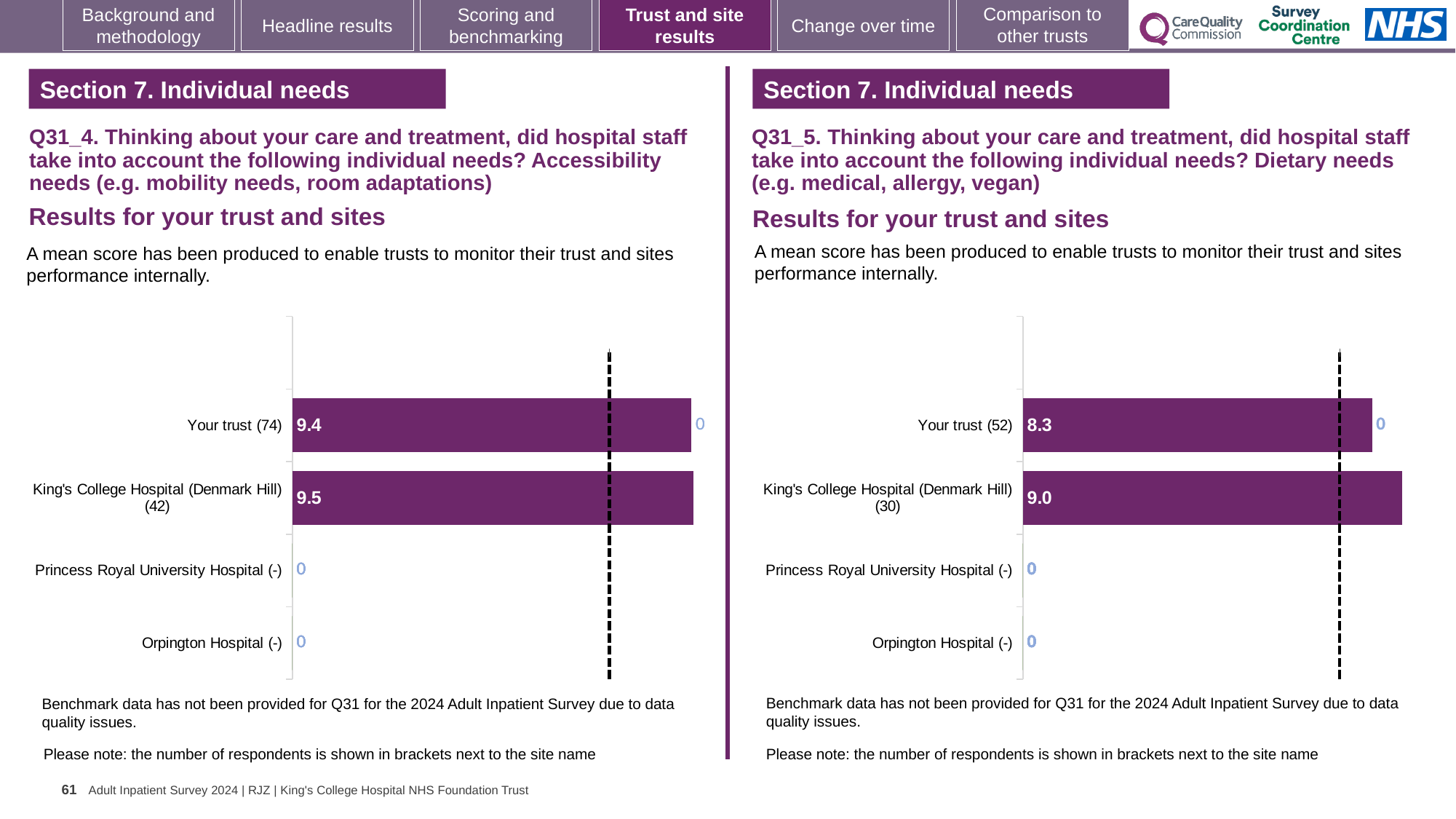
In the right chart (Q31_5), how many respondents are shown in brackets for King's College Hospital (Denmark Hill)? 30 In the right chart (Q31_5, dietary needs), which is larger: the score for Your trust or for King's College Hospital (Denmark Hill)? King's College Hospital (Denmark Hill) What type of chart is used in the right chart (Q31_5, dietary needs)? Bar chart In the left chart (Q31_4, accessibility needs), what is the mean score for Your trust? 9.4 In the right chart (Q31_5, dietary needs), what is the difference between the scores for King's College Hospital (Denmark Hill) and Your trust? 0.7 How many site categories are listed on the y axis of the left chart (Q31_4)? 4 Is the score for Your trust in the right chart (Q31_5, dietary needs) greater or less than the score for Your trust in the left chart (Q31_4, accessibility needs)? less In the left chart (Q31_4, accessibility needs), what is the difference between the scores for King's College Hospital (Denmark Hill) and Your trust? 0.1 In the left chart (Q31_4, accessibility needs), what is the mean score for King's College Hospital (Denmark Hill)? 9.5 In the right chart (Q31_5, dietary needs), what is the mean score for King's College Hospital (Denmark Hill)? 9.0 In the left chart (Q31_4), how many respondents are shown in brackets for Your trust? 74 In the right chart (Q31_5, dietary needs), what is the mean score for Your trust? 8.3